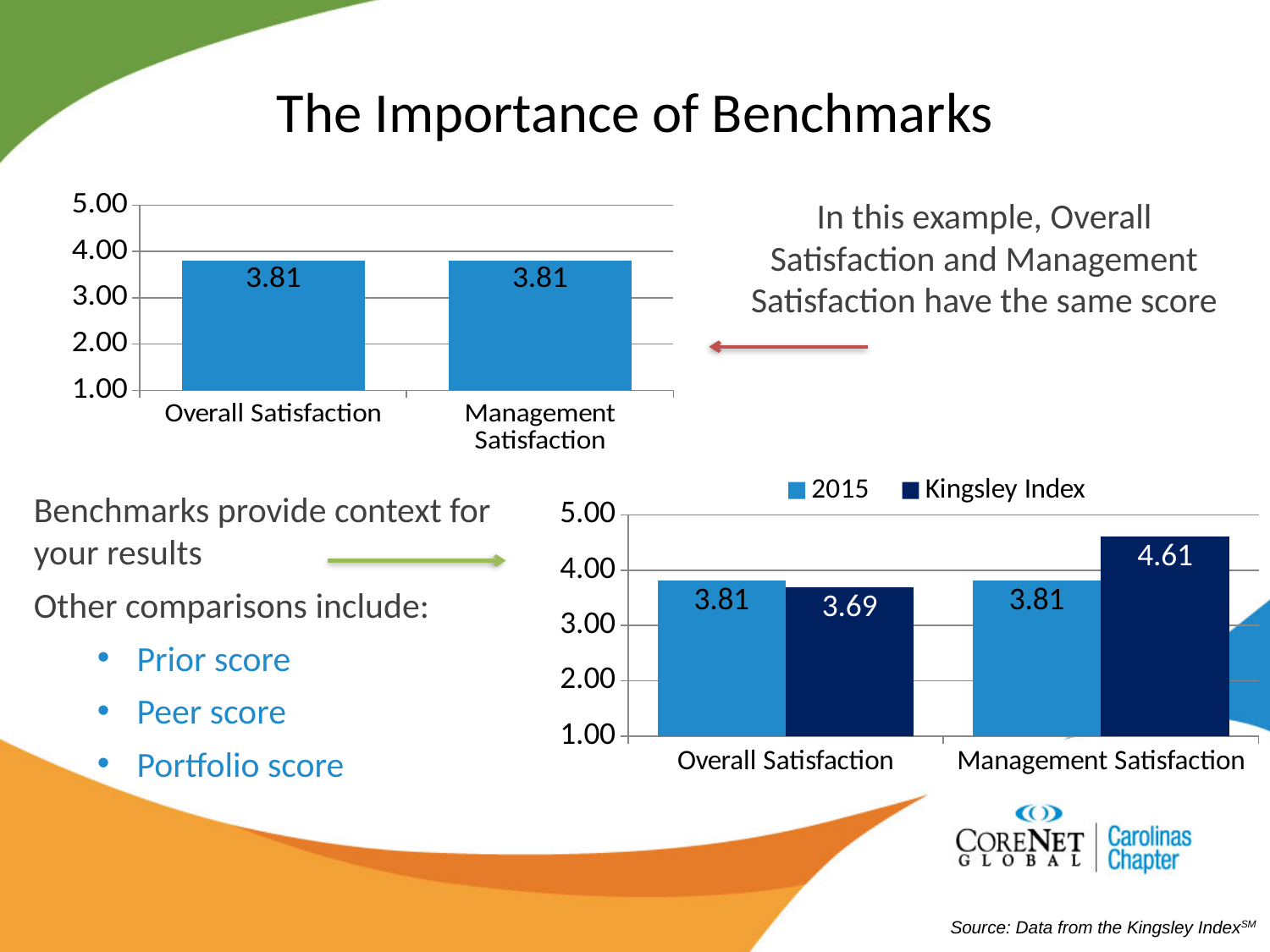
What kind of chart is the top-left chart? bar chart In the top-left chart, what is the value for Overall Satisfaction? 3.81 In the bottom-right chart, what is the 2015 value for Management Satisfaction? 3.81 In the top-left chart, what is the value for Management Satisfaction? 3.81 In the bottom-right chart, which category has the highest Kingsley Index value? Management Satisfaction In the bottom-right chart, what is the difference between the Kingsley Index value and the 2015 value for Management Satisfaction? 0.80 In the bottom-right chart, what is the Kingsley Index value for Overall Satisfaction? 3.69 In the bottom-right chart, which is larger for Overall Satisfaction: the 2015 value or the Kingsley Index value? 2015 In the bottom-right chart, how many series does the legend list? 2 In the top-left chart, how many categories are shown on the x axis? 2 In the bottom-right chart, what is the Kingsley Index value for Management Satisfaction? 4.61 In the bottom-right chart, what are the two series named in the legend? 2015 and Kingsley Index